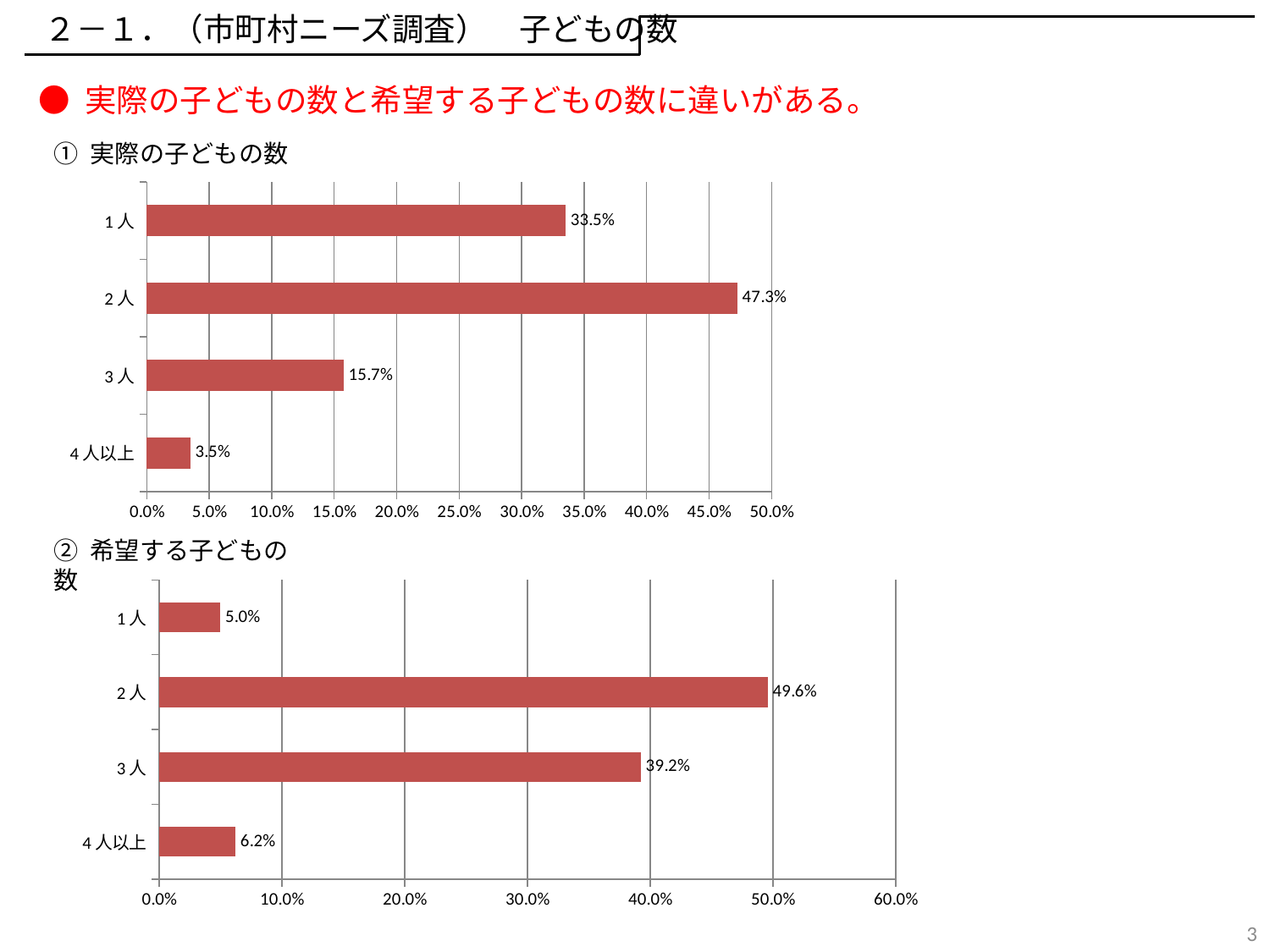
In the bottom chart (② 希望する子どもの数), which category has the lowest value? 1人 In the bottom chart (② 希望する子どもの数), which is larger, the value for 4人以上 or the value for 1人? 4人以上 In the bottom chart (② 希望する子どもの数), what is the value for 1人? 5.0% In the top chart (① 実際の子どもの数), what is the value for 4人以上? 3.5% In the top chart (① 実際の子どもの数), which category has the highest value? 2人 In the top chart (① 実際の子どもの数), what is the value for 2人? 47.3% What kind of chart is the top chart (① 実際の子どもの数)? bar chart In the bottom chart (② 希望する子どもの数), what is the value for 3人? 39.2% In the bottom chart (② 希望する子どもの数), what is the difference between the values for 2人 and 3人? 10.4% How many categories are shown in the bottom chart (② 希望する子どもの数)? 4 In the top chart (① 実際の子どもの数), is the value for 3人 greater or less than 20.0%? less In the top chart (① 実際の子どもの数), what is the difference between the values for 2人 and 1人? 13.8%